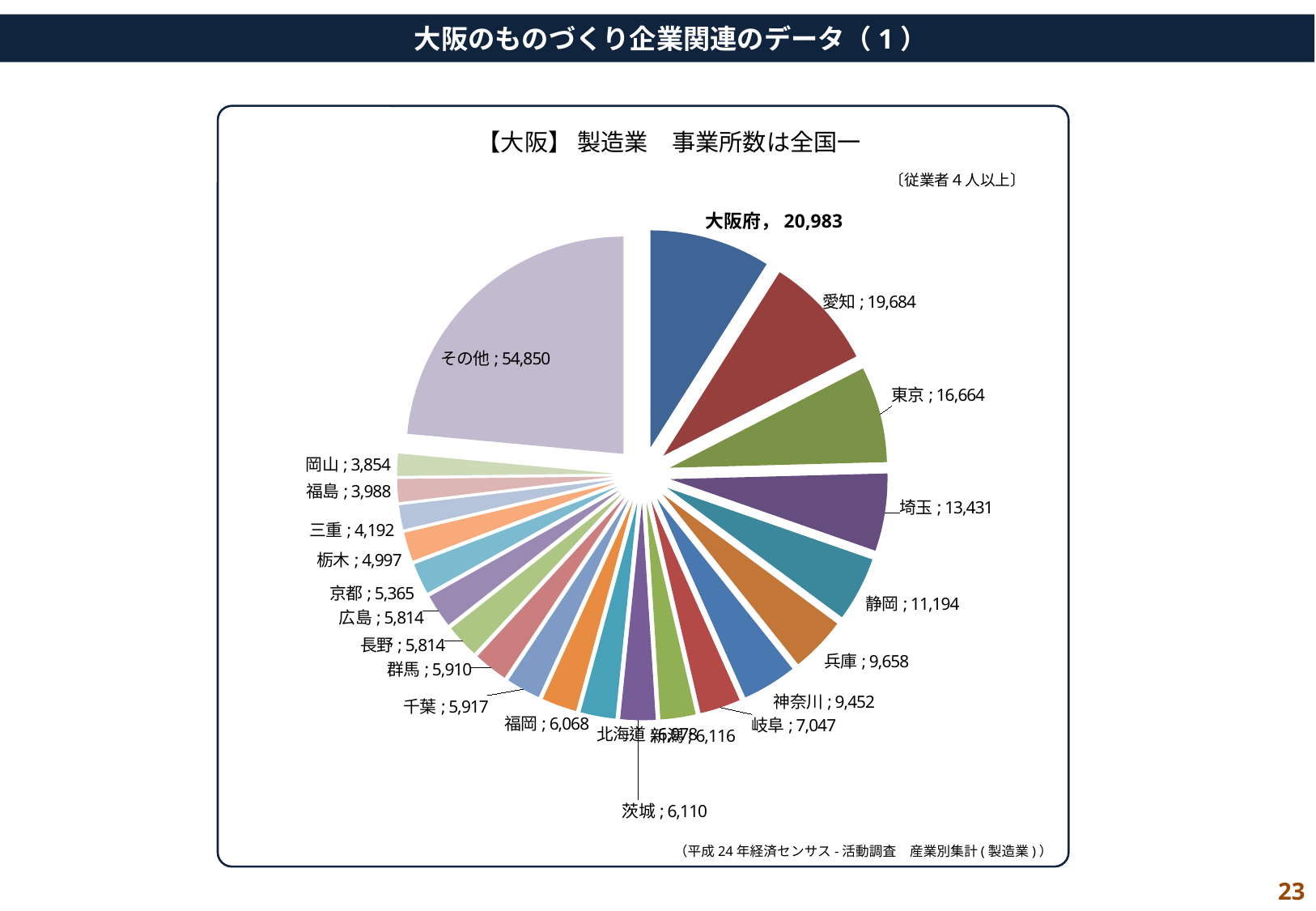
What kind of chart is shown on the slide? pie chart Which has a larger value, 兵庫 or 神奈川? 兵庫 What is the value shown for 大阪府? 20,983 What is the value shown for 愛知? 19,684 What is the title of the chart? 【大阪】 製造業 事業所数は全国一 What is the difference between the values for 大阪府 and 愛知? 1,299 What is the value shown for 岡山? 3,854 What is the value shown for 静岡? 11,194 Which individual prefecture has the highest value? 大阪府 Which slice of the pie is the largest? その他 What is the difference between the values for 東京 and 埼玉? 3,233 Which labeled prefecture has the lowest value? 岡山